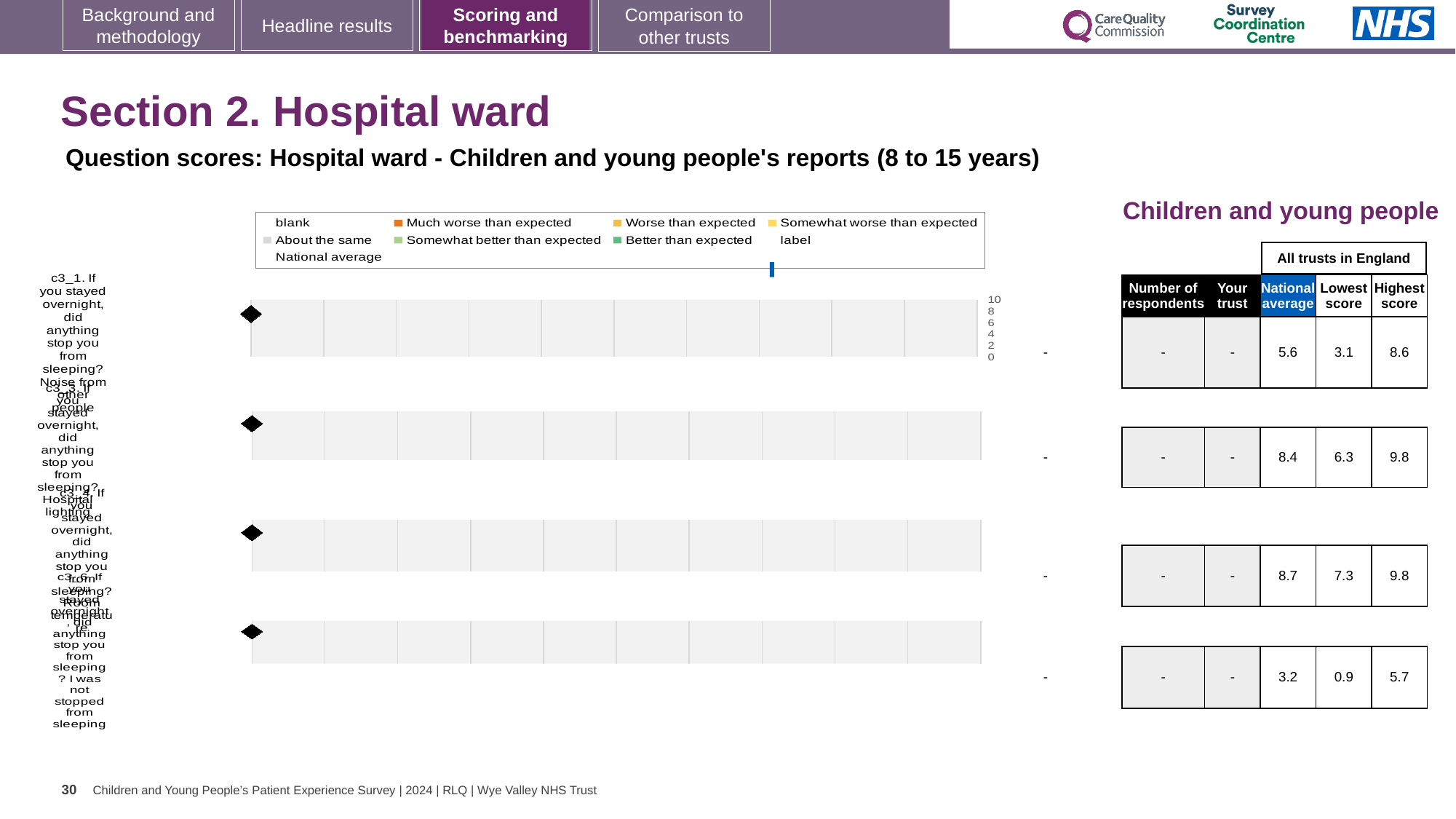
Which question row has the lowest national average in the table? c3_6 (I was not stopped from sleeping) Which question row has the highest national average in the table? c3_4 (room temperature) In the table, what is the highest score for the second question row (c3_3, hospital lighting)? 9.8 What is the highest tick value shown on the chart's axis? 10 In the table, what is the national average for the first question row (c3_1, noise from other people)? 5.6 What is the difference between the highest score and the lowest score for the first question row (c3_1) in the table? 5.5 How many question rows (categories) are plotted in the chart? 4 In the table, what is the lowest score for the third question row (c3_4, room temperature)? 7.3 In the table, what is the national average for the fourth question row (c3_6, I was not stopped from sleeping)? 3.2 What kind of chart is shown on the slide? bar chart How many entries does the chart legend list? 9